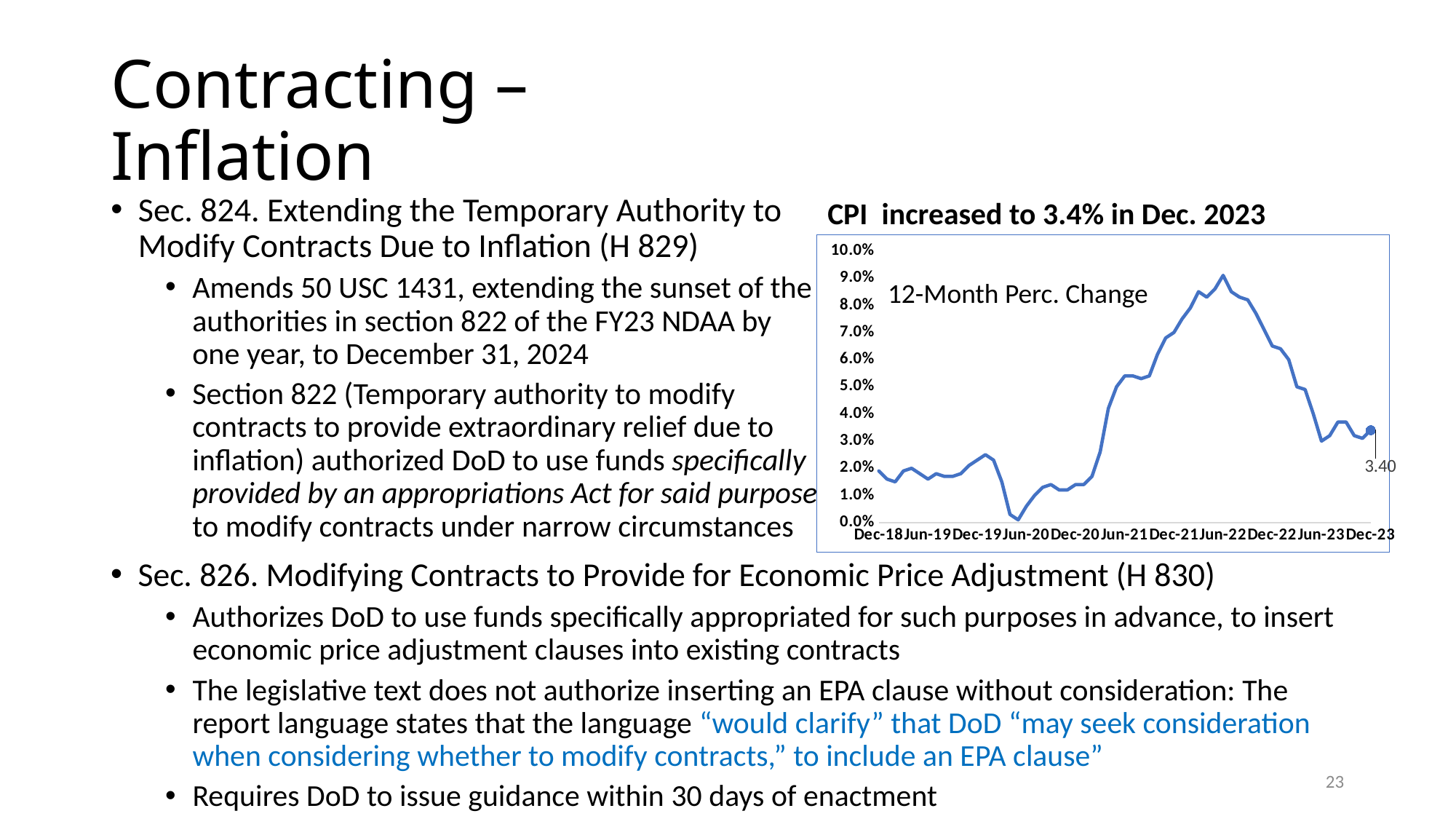
Is the value at Jun-19 greater or less than 2.0%? less Does the line rise or fall between Jun-22 and Jun-23? fall What is the title of the chart? CPI increased to 3.4% in Dec. 2023 Is the value at Jun-20 greater or less than 1.0%? less What value is labelled at the Dec-23 data point? 3.40 What series label is printed inside the chart area? 12-Month Perc. Change Which is higher, the value at Jun-21 or the value at Jun-23? Jun-21 At which labelled x-axis date does the line reach its lowest value? Jun-20 At which labelled x-axis date does the line reach its highest value? Jun-22 Is the value at Dec-21 greater or less than 6.0%? greater What kind of chart is shown on the slide? line chart